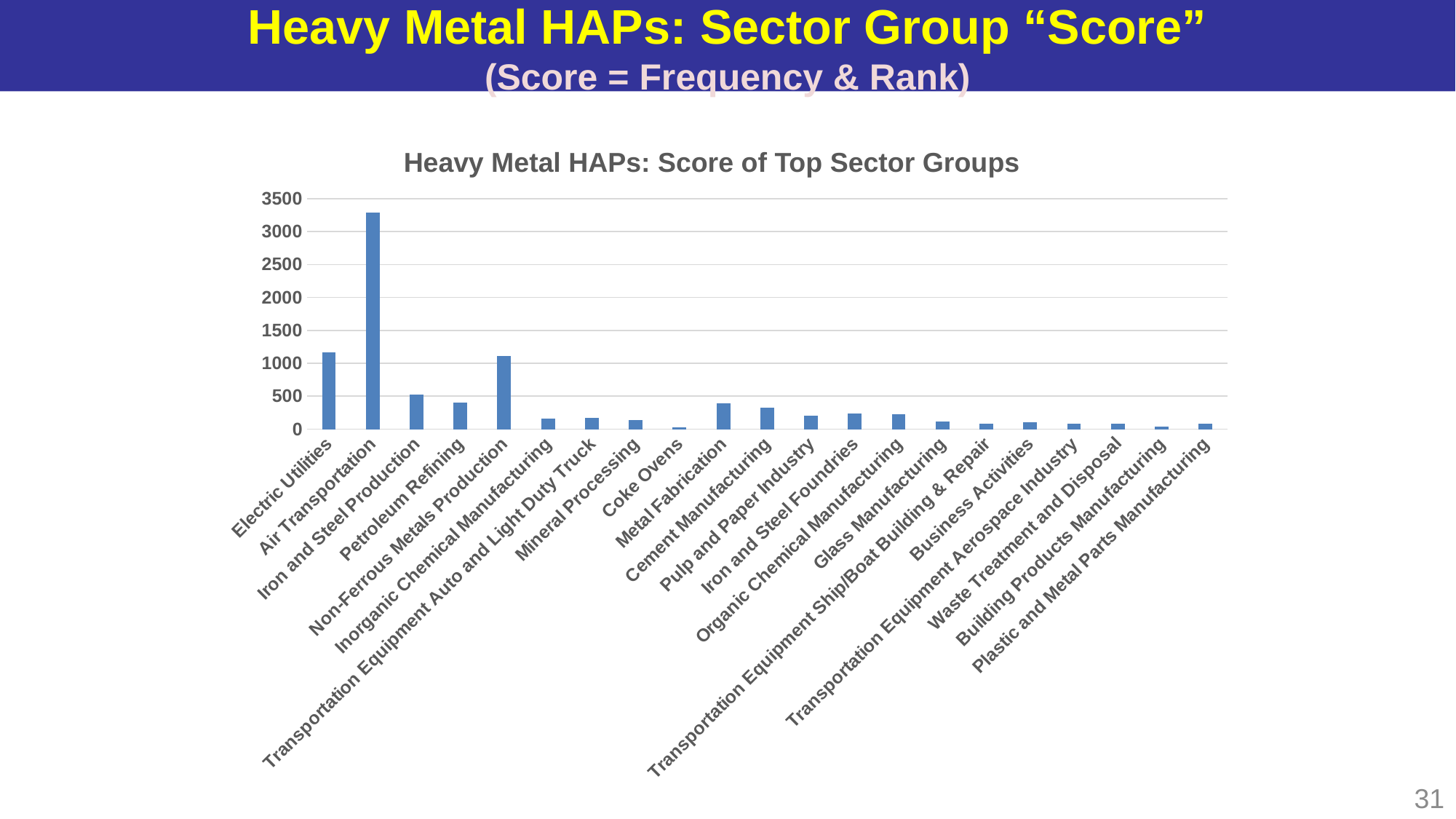
Which sector group has the highest score? Air Transportation How many sector groups are plotted on the chart? 21 What is the title of the chart? Heavy Metal HAPs: Score of Top Sector Groups Is the score for Petroleum Refining greater or less than 500? less Is the score for Electric Utilities greater or less than 1000? greater Is the score for Air Transportation greater or less than 3000? greater What type of chart is shown on the slide? Bar chart Which has a higher score, Air Transportation or Non-Ferrous Metals Production? Air Transportation Which has a higher score, Metal Fabrication or Glass Manufacturing? Metal Fabrication Which has a higher score, Electric Utilities or Iron and Steel Production? Electric Utilities